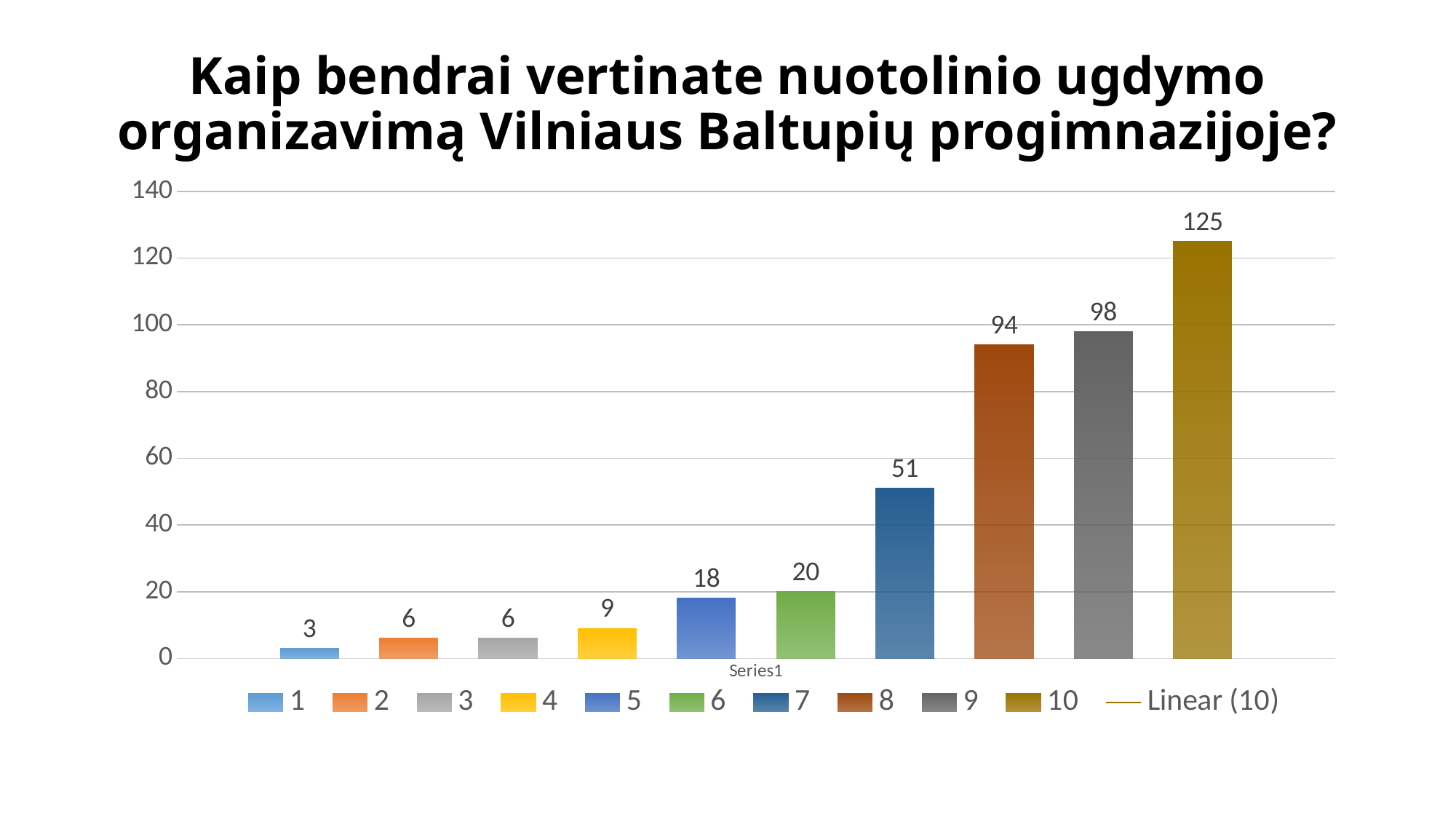
What kind of chart is shown on the slide? bar chart Which rating has the lowest value? 1 What is the value for rating 7? 51 Is the value for rating 8 greater or less than 80? greater What is the value for rating 10? 125 What is the difference between the values for rating 8 and rating 7? 43 What is the difference between the values for rating 10 and rating 9? 27 What is the value for rating 5? 18 Which rating has the highest value? 10 Do the values rise or fall from rating 1 to rating 10? rise Which is larger, the value for rating 6 or the value for rating 5? 6 How many bars are plotted on the chart? 10